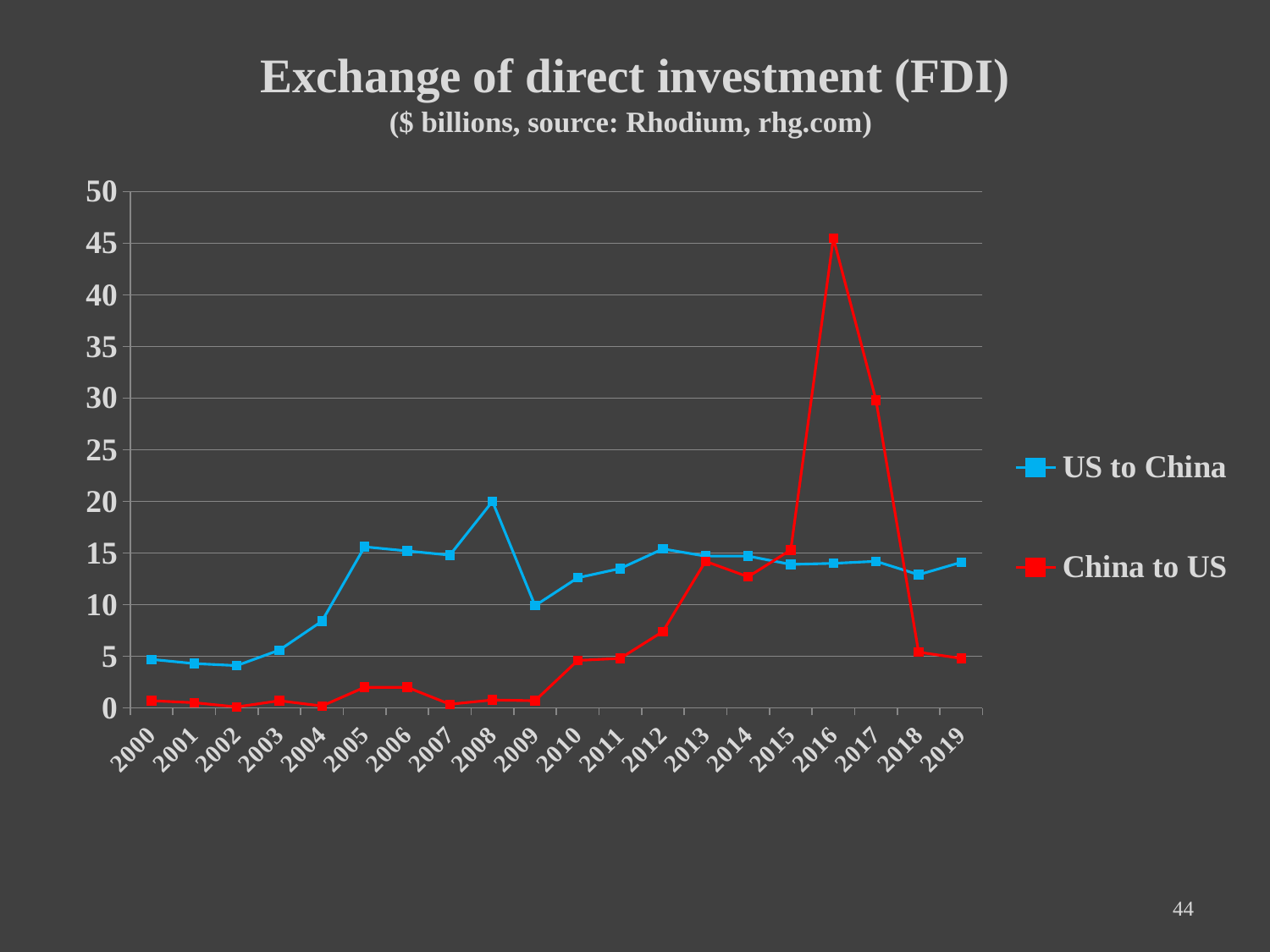
Does the China to US series rise or fall from 2016 to 2018? fall Is the US to China value for 2000 greater or less than 10? less In 2005, which series has the larger value, US to China or China to US? US to China Is the China to US value for 2016 greater or less than 40? greater In which year does the US to China series reach its highest value? 2008 In 2016, which series has the larger value, US to China or China to US? China to US How many series does the legend list? 2 What kind of chart is shown on the slide? line chart Which colour is used for the China to US series? red Is the China to US value for 2017 greater or less than 25? greater In which year does the China to US series reach its highest value? 2016 How many years are plotted along the x axis? 20